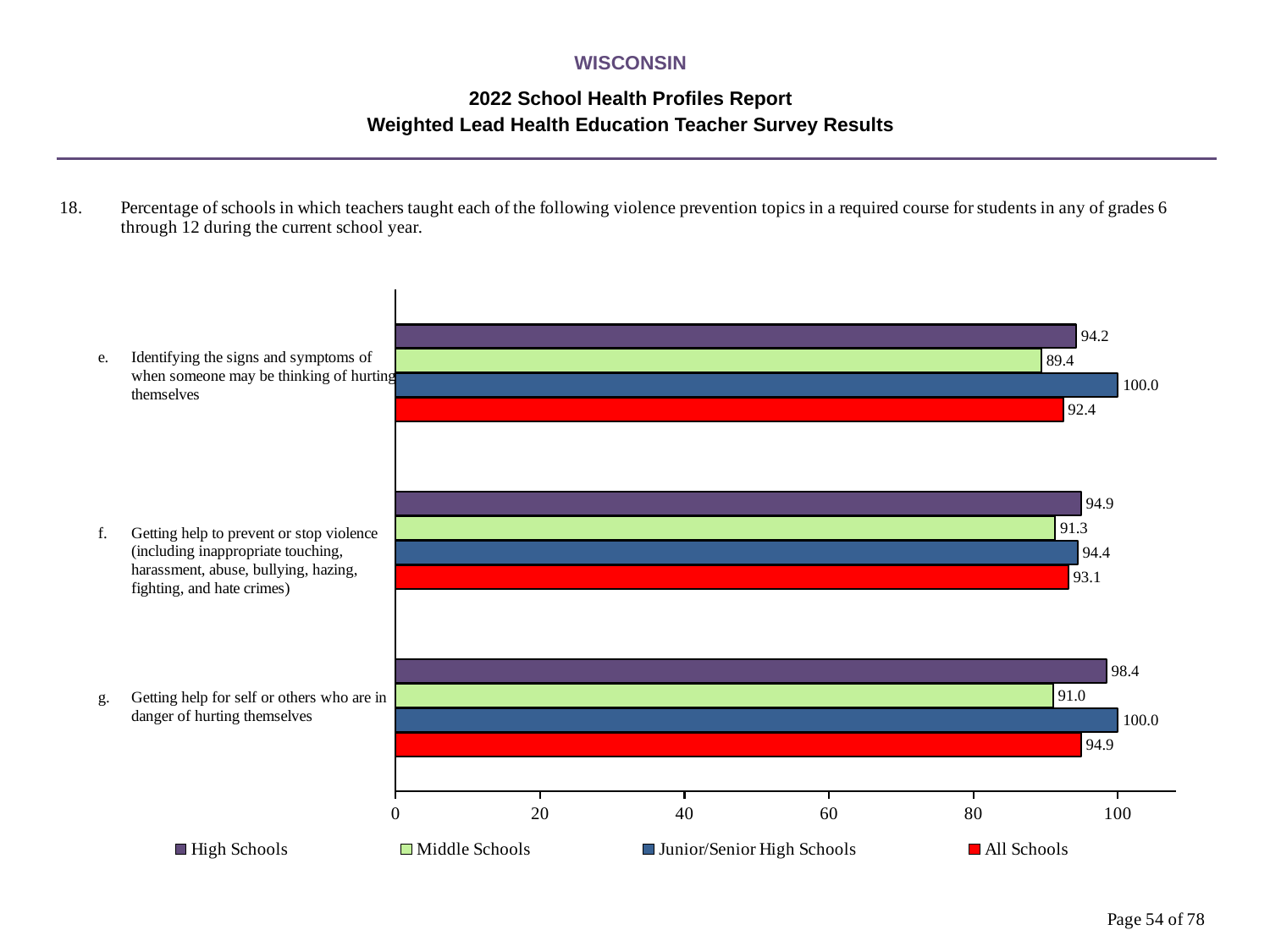
What kind of chart is shown on the slide? Bar chart What is the value for All Schools for topic g, getting help for self or others who are in danger of hurting themselves? 94.9 What is the difference between the High Schools and Middle Schools values for topic g? 7.4 How many series does the legend list? 4 Which series has the lowest value for topic g, getting help for self or others who are in danger of hurting themselves? Middle Schools What is the value for Junior/Senior High Schools for topic e? 100.0 Which colour represents All Schools in the legend? Red How many topics (categories) are shown on the chart? 3 What is the value for High Schools for topic e, identifying the signs and symptoms of when someone may be thinking of hurting themselves? 94.2 Which series has the highest value for topic f, getting help to prevent or stop violence? High Schools Which is larger for topic e: the All Schools value or the Middle Schools value? All Schools What is the value for Middle Schools for topic f, getting help to prevent or stop violence? 91.3